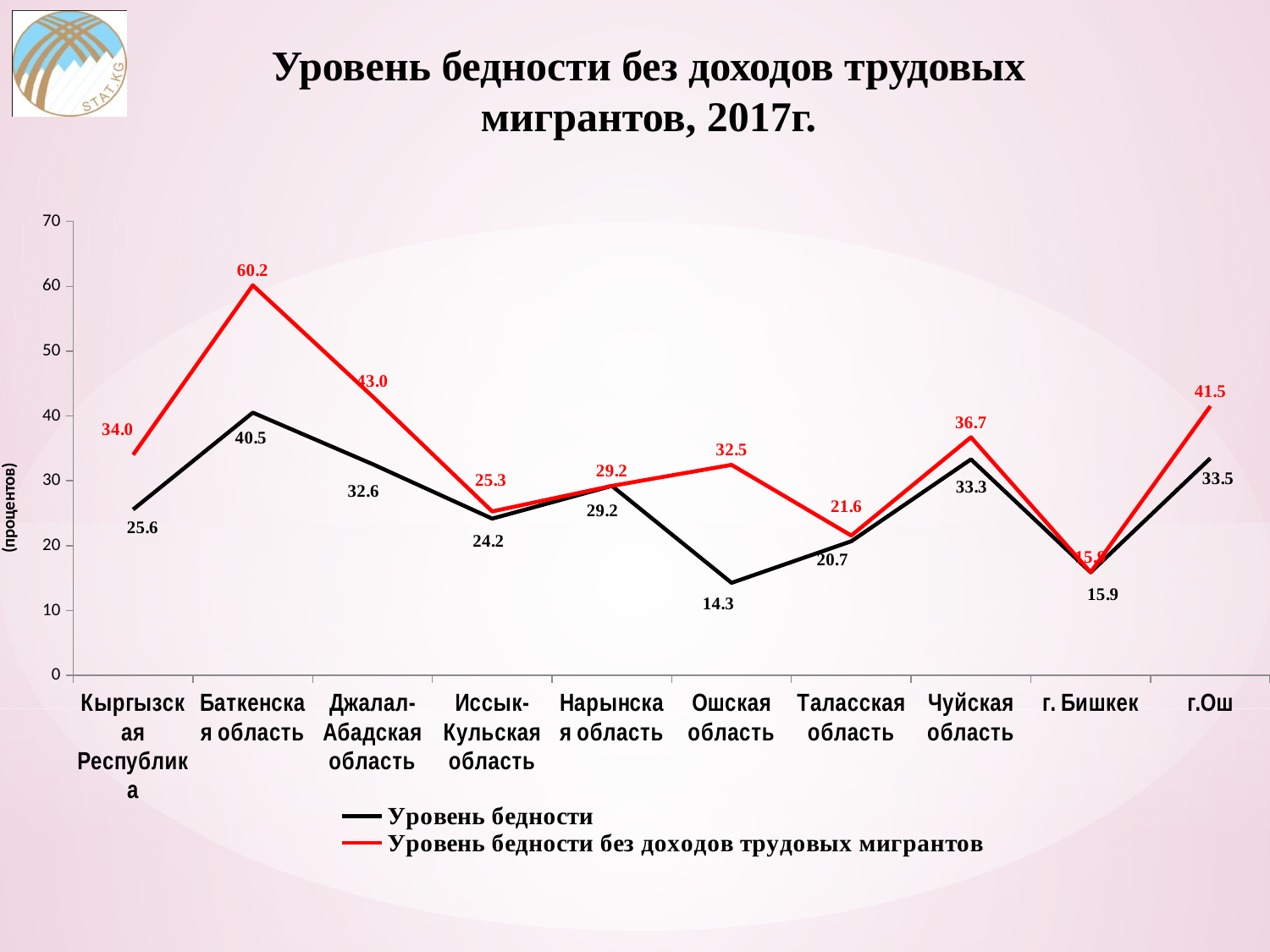
Which region has the lowest value for 'Уровень бедности'? Ошская область How many regions (categories) are plotted along the x axis? 10 For Ошская область, what is the difference between 'Уровень бедности без доходов трудовых мигрантов' and 'Уровень бедности'? 18.2 What kind of chart is shown on the slide? line chart Which region has the highest value for 'Уровень бедности без доходов трудовых мигрантов'? Баткенская область What is the value of 'Уровень бедности' for Нарынская область? 29.2 Which is larger for 'Уровень бедности без доходов трудовых мигрантов': Джалал-Абадская область or г.Ош? Джалал-Абадская область What is the value of 'Уровень бедности без доходов трудовых мигрантов' for Баткенская область? 60.2 For Баткенская область, what is the difference between 'Уровень бедности без доходов трудовых мигрантов' and 'Уровень бедности'? 19.7 Which colour is used for the 'Уровень бедности без доходов трудовых мигрантов' line? red What is the value of 'Уровень бедности' for Ошская область? 14.3 How many series does the legend list? 2